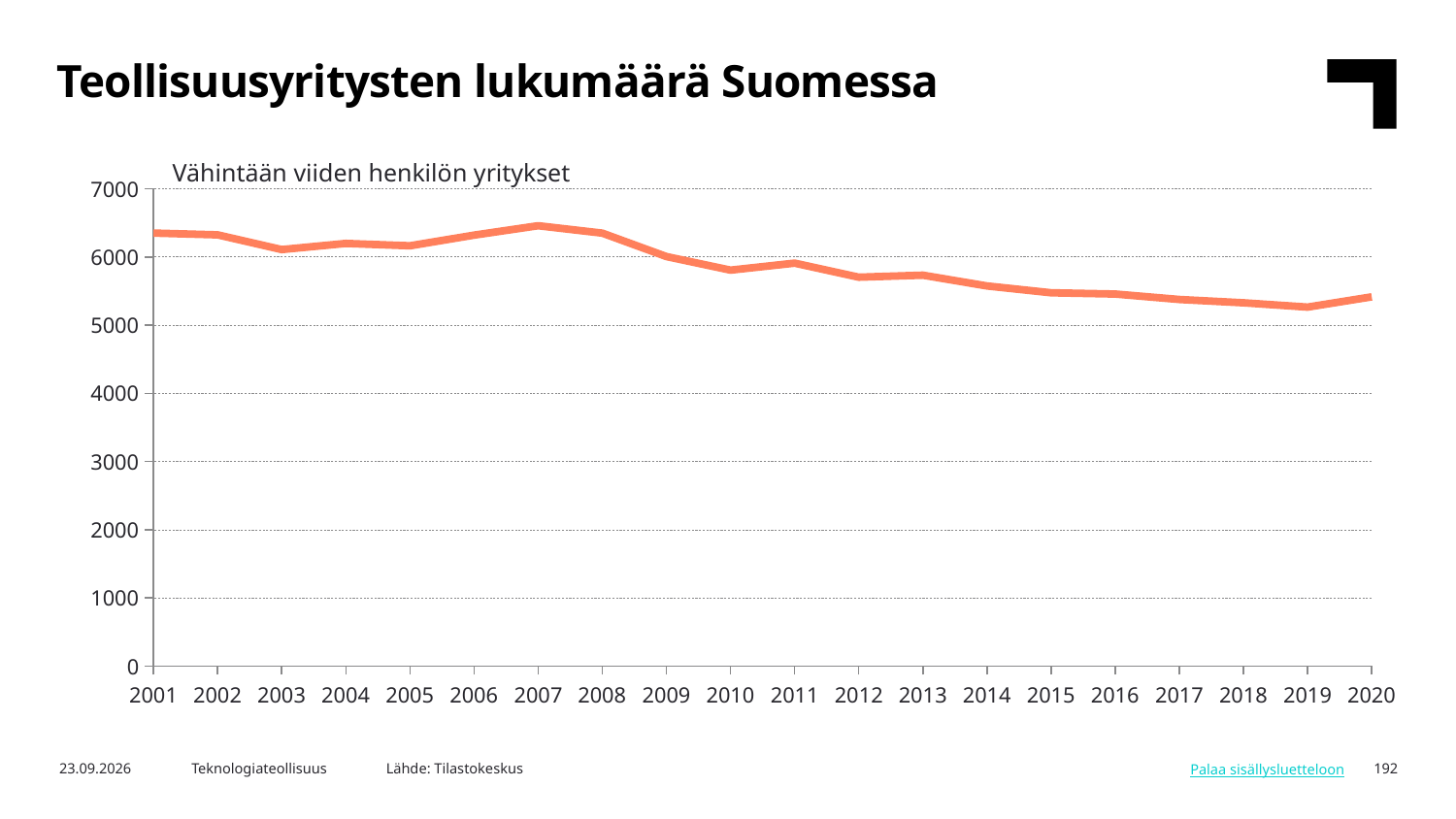
Overall, do the values rise or fall from 2001 to 2020? fall Is the value for 2020 greater or less than 5000? greater What kind of chart is shown on the slide? line chart What subtitle is shown above the chart? Vähintään viiden henkilön yritykset Is the value for 2013 greater or less than 6000? less Is the value for 2019 greater or less than 6000? less How many years are plotted along the x axis? 20 Which is larger, the value for 2001 or the value for 2020? 2001 Which year has the highest value? 2007 What is the title of the slide? Teollisuusyritysten lukumäärä Suomessa